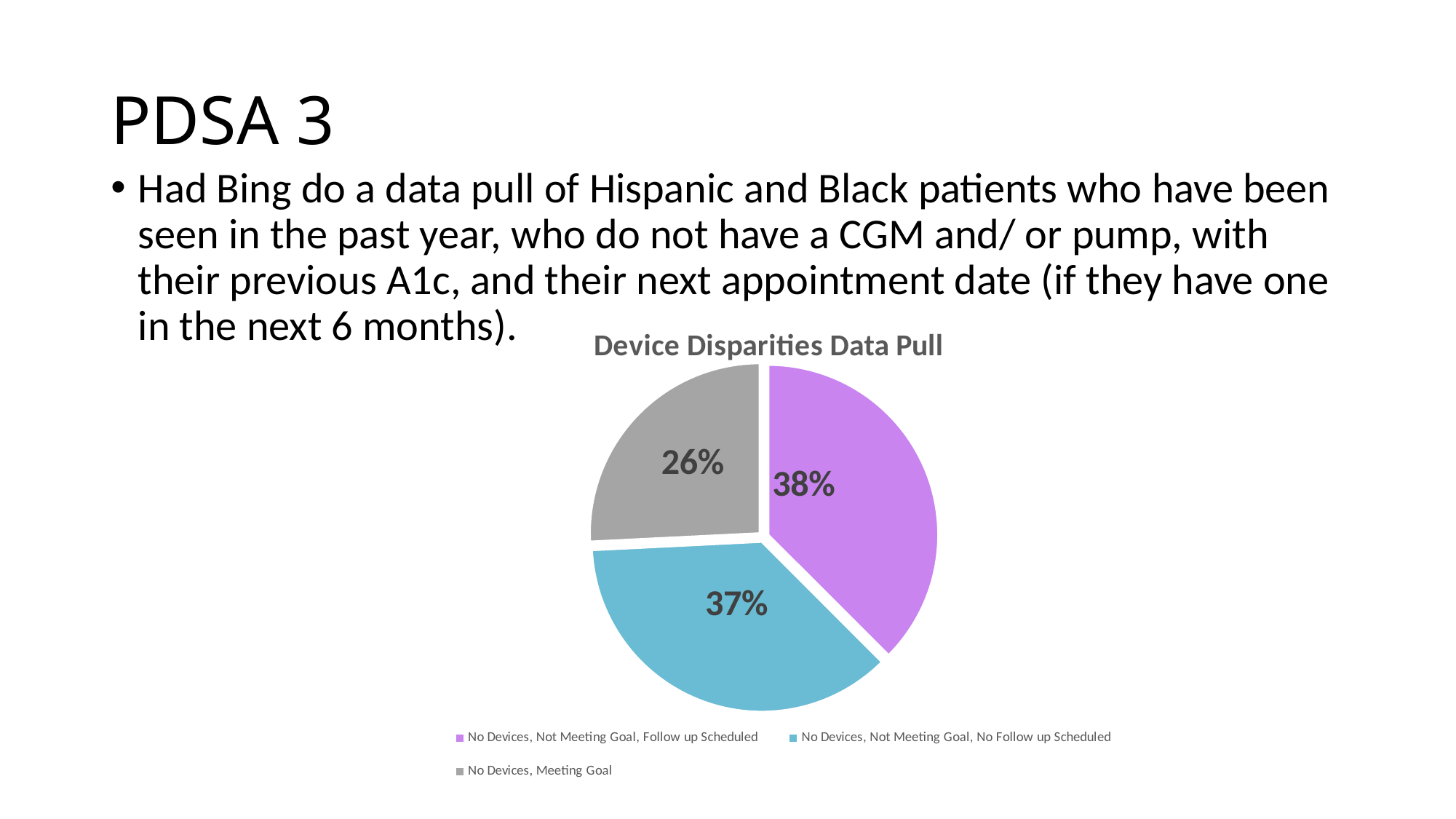
What colour is the slice for 'No Devices, Meeting Goal'? gray Which category has the largest share of the pie? No Devices, Not Meeting Goal, Follow up Scheduled What is the difference in percentage points between 'No Devices, Not Meeting Goal, Follow up Scheduled' and 'No Devices, Meeting Goal'? 12 What type of chart is shown on the slide? pie chart Which is larger: the share for 'No Devices, Not Meeting Goal, No Follow up Scheduled' or the share for 'No Devices, Meeting Goal'? No Devices, Not Meeting Goal, No Follow up Scheduled Which category has the smallest share of the pie? No Devices, Meeting Goal What is the title of the chart? Device Disparities Data Pull What percentage of the pie is 'No Devices, Meeting Goal'? 26% What percentage of the pie is 'No Devices, Not Meeting Goal, No Follow up Scheduled'? 37% How many slices does the pie chart have? 3 What percentage of the pie is 'No Devices, Not Meeting Goal, Follow up Scheduled'? 38% How many entries does the legend list? 3